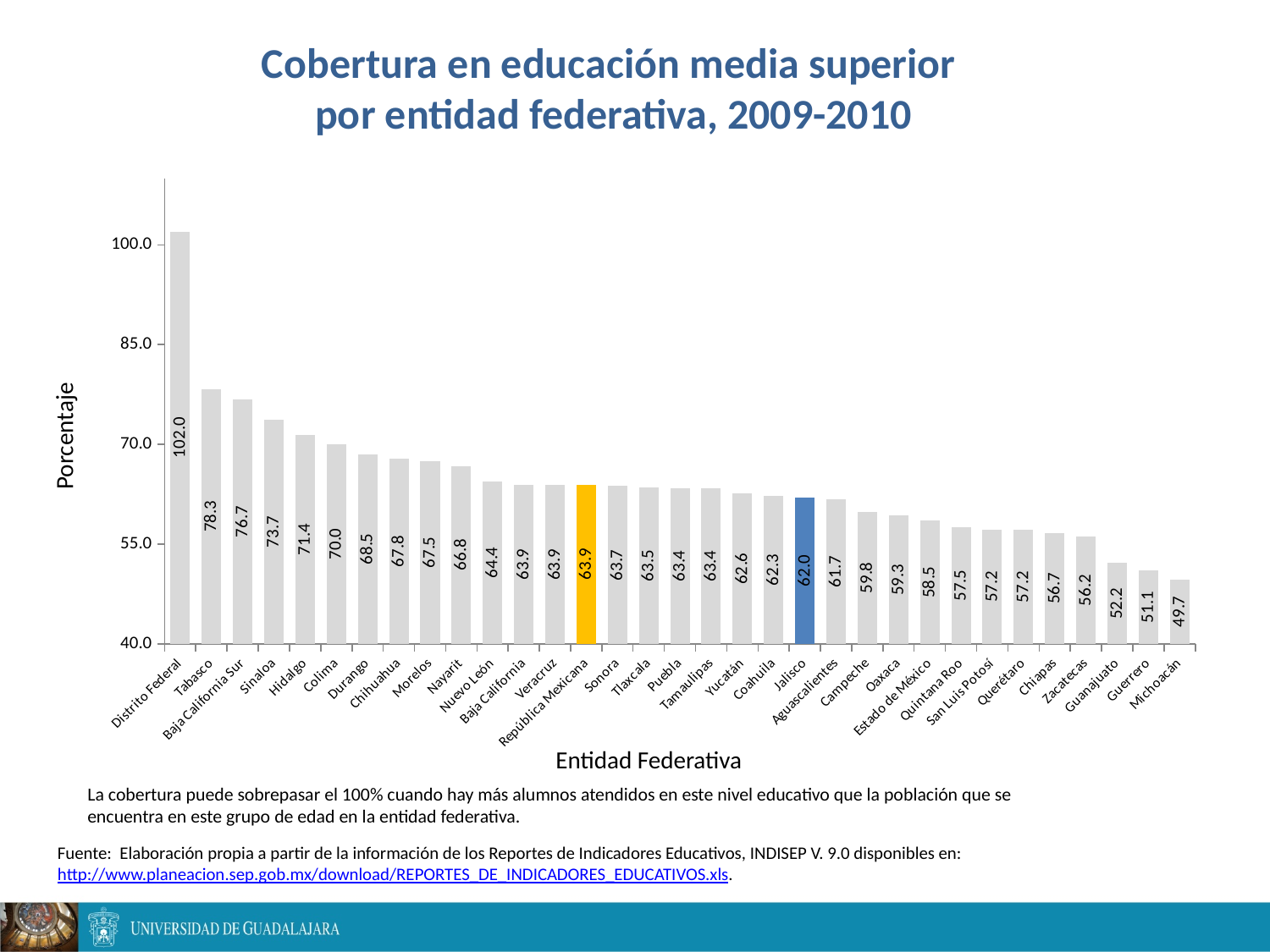
How many bars are plotted in the chart? 33 What is the difference between the values for Distrito Federal and Tabasco? 23.7 Is the value for Colima greater or less than 55.0? greater Which entity has the highest value? Distrito Federal What is the difference between the values for República Mexicana and Jalisco? 1.9 What is the value for Jalisco? 62.0 What is the value for Michoacán? 49.7 What is the value for República Mexicana? 63.9 What kind of chart is shown on the slide? bar chart What is the label of the vertical axis? Porcentaje Which is larger, the value for Sinaloa or the value for Hidalgo? Sinaloa Which entity has the lowest value? Michoacán